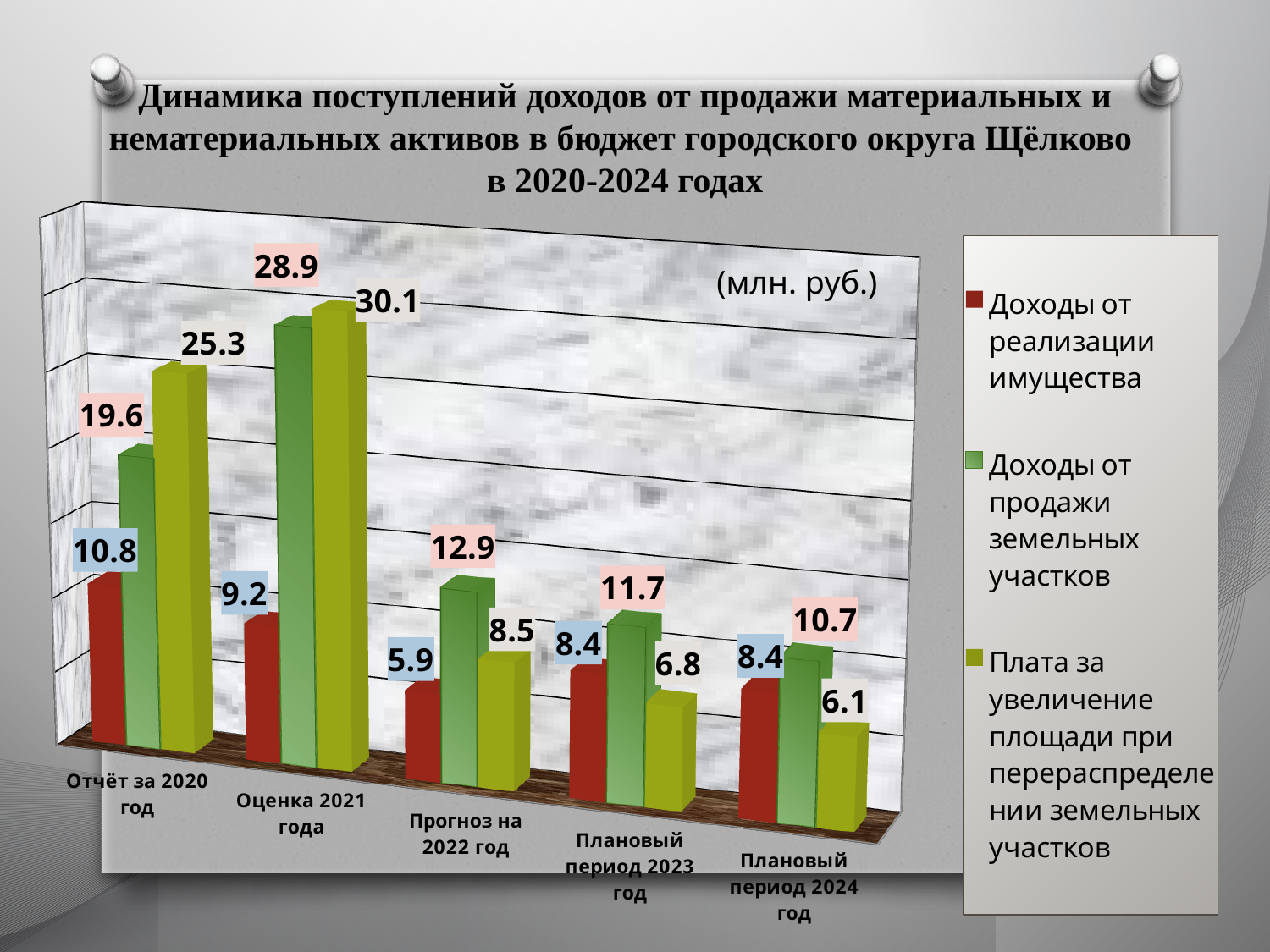
In which category is 'Доходы от продажи земельных участков' highest? Оценка 2021 года What unit of measurement is indicated on the chart? млн. руб. What is the total of the three series for 'Отчёт за 2020 год'? 55.7 What is the value of 'Доходы от реализации имущества' for 'Отчёт за 2020 год'? 10.8 In which category is 'Доходы от реализации имущества' lowest? Прогноз на 2022 год How many series does the legend list? 3 How many categories are shown along the x axis? 5 What is the value of 'Плата за увеличение площади при перераспределении земельных участков' for 'Оценка 2021 года'? 30.1 Which is larger for 'Плановый период 2023 год': 'Доходы от реализации имущества' or 'Плата за увеличение площади при перераспределении земельных участков'? Доходы от реализации имущества What type of chart is shown on the slide? bar chart What is the value of 'Доходы от продажи земельных участков' for 'Плановый период 2024 год'? 10.7 What is the difference between 'Доходы от продажи земельных участков' and 'Доходы от реализации имущества' for 'Прогноз на 2022 год'? 7.0